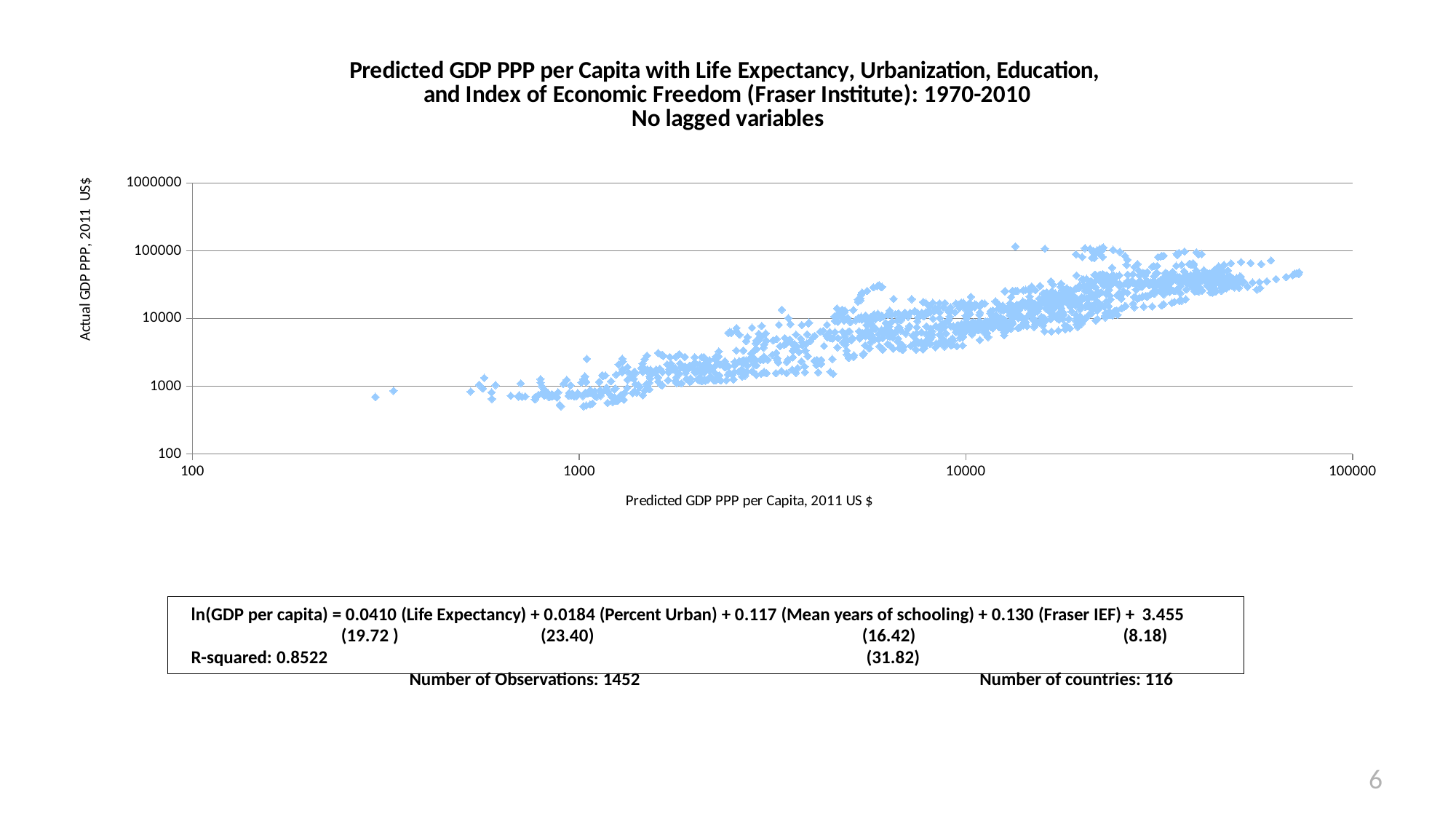
Is the lowest plotted actual GDP PPP value greater or less than 1000? less What kind of chart is shown on the slide? Scatter chart Do the plotted values of actual GDP PPP per capita generally rise or fall as predicted GDP PPP per capita increases along the x axis? Rise What is the highest tick value shown on the y axis? 1000000 What is the lowest tick value shown on the x axis? 100 What is the label of the x axis of the chart? Predicted GDP PPP per Capita, 2011 US $ Is the predicted GDP PPP per capita of the leftmost plotted point greater or less than 1000? less What is the label of the y axis of the chart? Actual GDP PPP, 2011 US$ What R-squared value is reported for the regression shown on the slide? 0.8522 How many observations are plotted in the chart, according to the slide? 1452 How many countries does the slide say are included in the data? 116